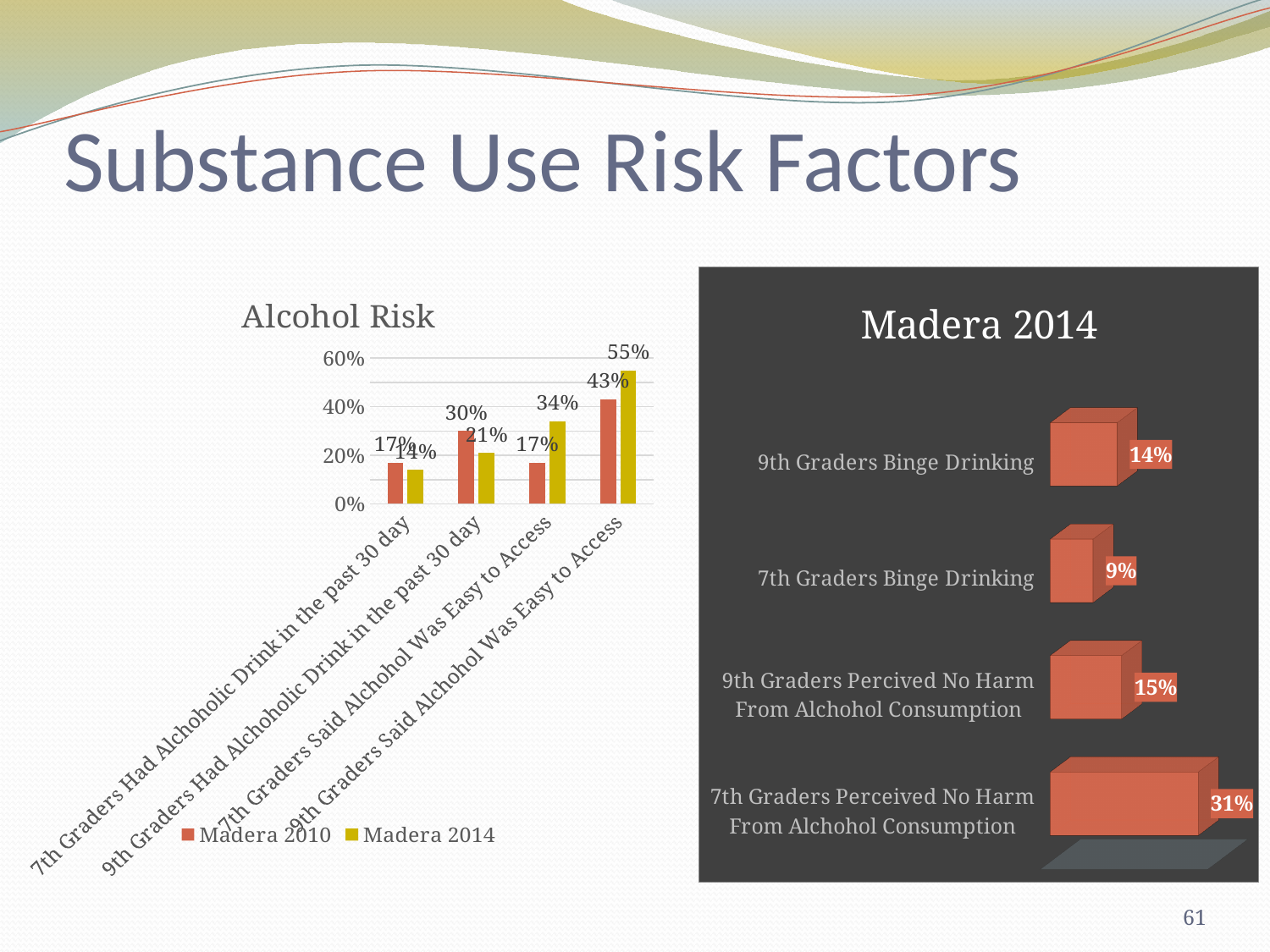
In the Alcohol Risk chart, what is the Madera 2014 value for 7th Graders Said Alcohol Was Easy to Access? 34% In the Alcohol Risk chart, what is the Madera 2014 value for 9th Graders Said Alcohol Was Easy to Access? 55% In the Alcohol Risk chart, how many series does the legend list? 2 In the Alcohol Risk chart, what is the difference between the Madera 2014 and Madera 2010 values for 9th Graders Said Alcohol Was Easy to Access? 12% In the Madera 2014 chart, which category has the lowest value? 7th Graders Binge Drinking In the Madera 2014 chart, what is the difference between 7th Graders Perceived No Harm From Alchohol Consumption and 9th Graders Percived No Harm From Alchohol Consumption? 16% In the Alcohol Risk chart, which is larger for 9th Graders Had Alcoholic Drink in the past 30 day: Madera 2010 or Madera 2014? Madera 2010 In the Alcohol Risk chart, which category has the highest Madera 2014 value? 9th Graders Said Alcohol Was Easy to Access In the Madera 2014 chart, what is the value for 7th Graders Perceived No Harm From Alchohol Consumption? 31% In the Madera 2014 chart, what is the value for 9th Graders Binge Drinking? 14% What kind of chart is the Madera 2014 chart? Bar chart In the Alcohol Risk chart, what is the Madera 2010 value for 9th Graders Had Alcoholic Drink in the past 30 day? 30%